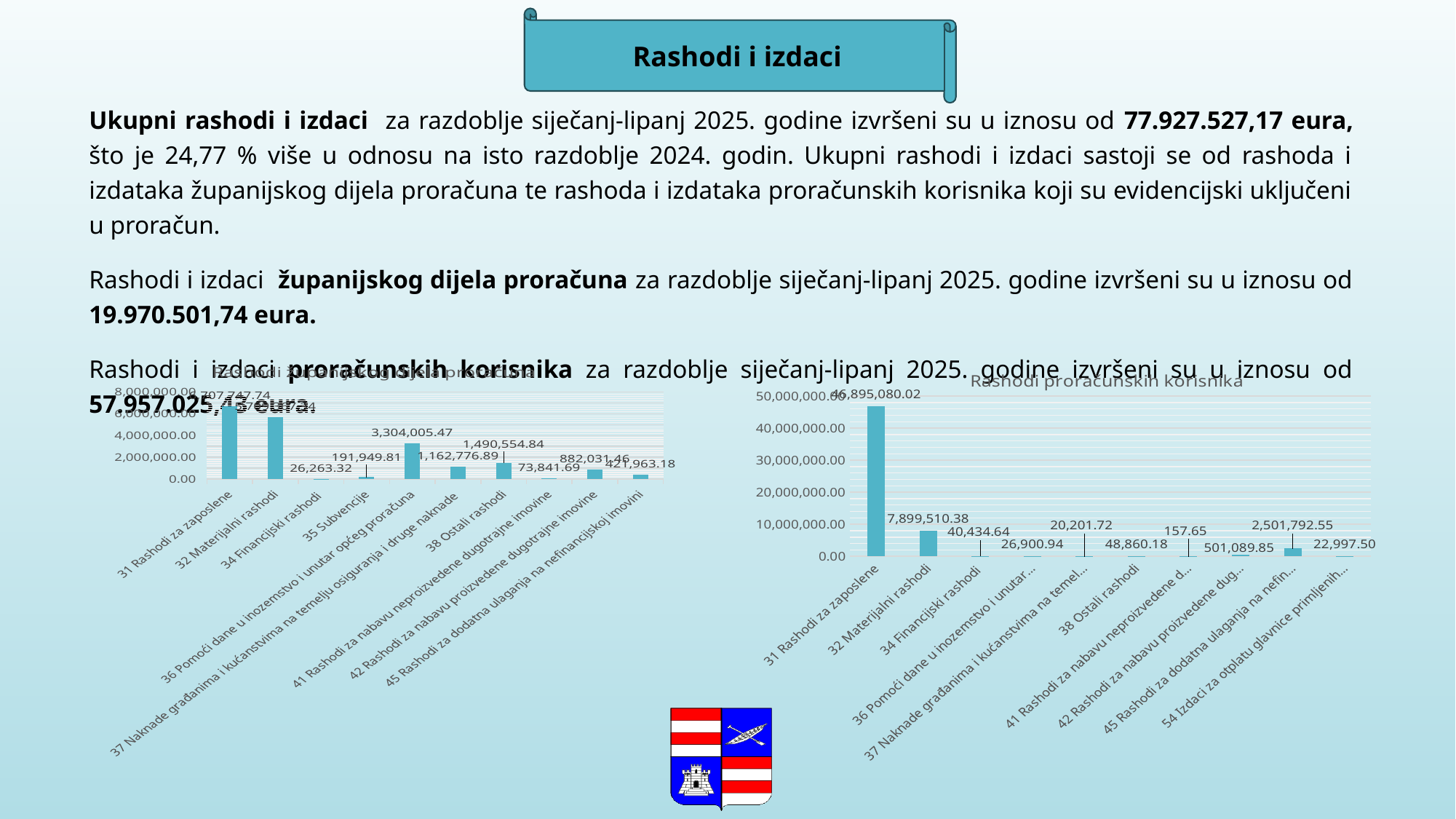
In the chart titled 'Rashodi proračunskih korisnika', how many categories are shown on the x axis? 10 In the chart titled 'Rashodi proračunskih korisnika', what is the value for 38 Ostali rashodi? 48,860.18 In the left chart, what is the value for 38 Ostali rashodi? 1,490,554.84 In the chart titled 'Rashodi proračunskih korisnika', what is the value for 31 Rashodi za zaposlene? 46,895,080.02 In the chart titled 'Rashodi proračunskih korisnika', is the value for 31 Rashodi za zaposlene greater or less than 40,000,000.00? greater In the chart titled 'Rashodi proračunskih korisnika', what is the value for 32 Materijalni rashodi? 7,899,510.38 In the left chart, what is the difference between 36 Pomoći dane u inozemstvo i unutar općeg proračuna and 38 Ostali rashodi? 1,813,450.63 In the chart titled 'Rashodi proračunskih korisnika', which category has the lowest value? 41 Rashodi za nabavu neproizvedene d... In the left chart, which category has the lowest value? 34 Financijski rashodi What kind of chart is the chart titled 'Rashodi proračunskih korisnika'? bar chart In the left chart, what is the value for 36 Pomoći dane u inozemstvo i unutar općeg proračuna? 3,304,005.47 In the chart titled 'Rashodi proračunskih korisnika', what is the difference between 31 Rashodi za zaposlene and 32 Materijalni rashodi? 38,995,569.64